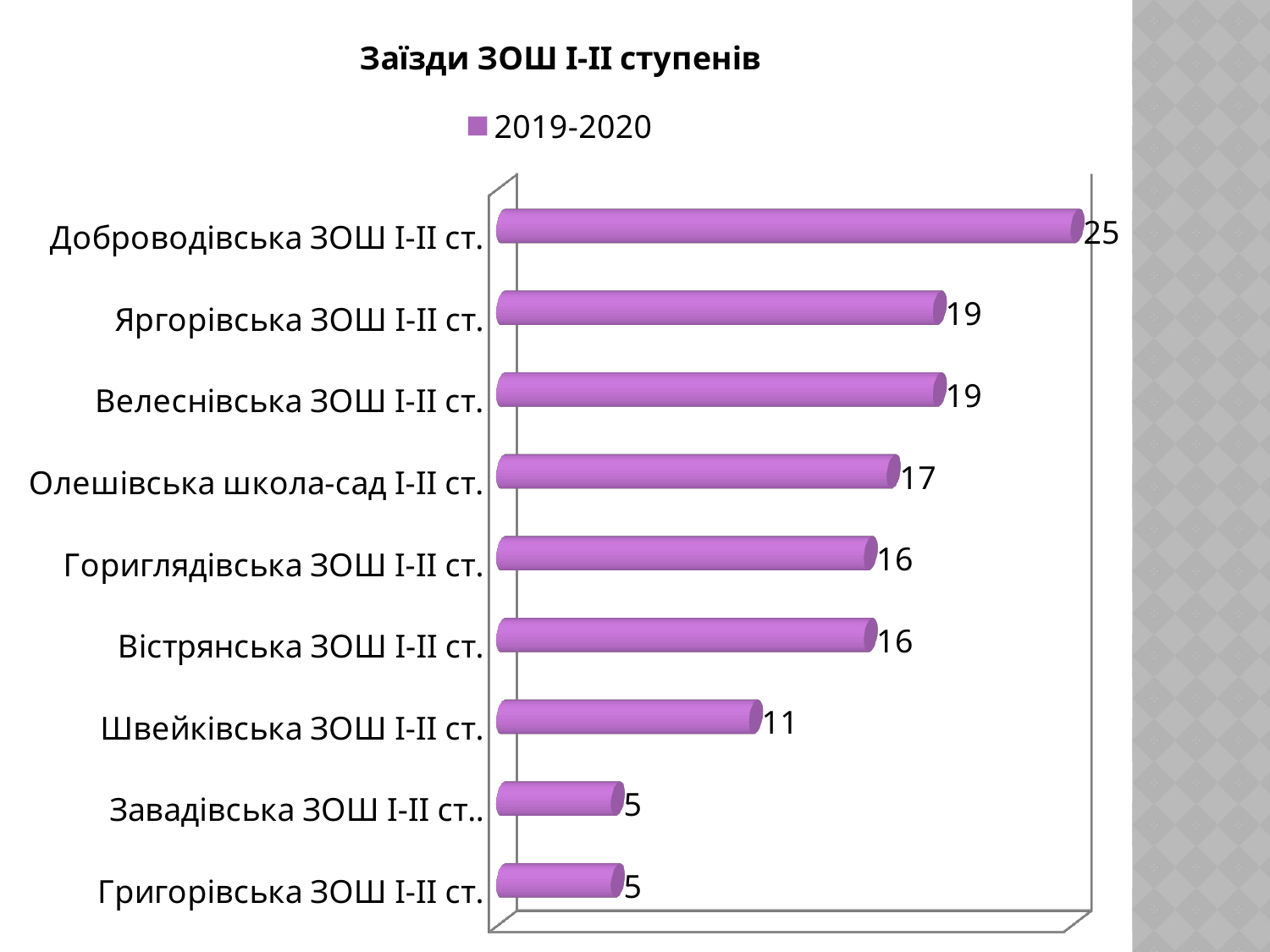
What is the title of the chart? Заїзди ЗОШ І-ІІ ступенів What series name is shown in the legend? 2019-2020 What is the difference between the values for Доброводівська ЗОШ І-ІІ ст. and Яргорівська ЗОШ І-ІІ ст.? 6 Which category has the highest value? Доброводівська ЗОШ І-ІІ ст. How many categories are shown in the chart? 9 What is the value for Доброводівська ЗОШ І-ІІ ст.? 25 What is the difference between the values for Горигляд��вська ЗОШ І-ІІ ст. and Швейківська ЗОШ І-ІІ ст.? 5 How many series does the legend list? 1 What kind of chart is shown? bar chart Which is larger, the value for Велеснівська ЗОШ І-ІІ ст. or the value for Вістрянська ЗОШ І-ІІ ст.? Велеснівська ЗОШ І-ІІ ст. What is the value for Олешівська школа-сад І-ІІ ст.? 17 What is the value for Швейківська ЗОШ І-ІІ ст.? 11